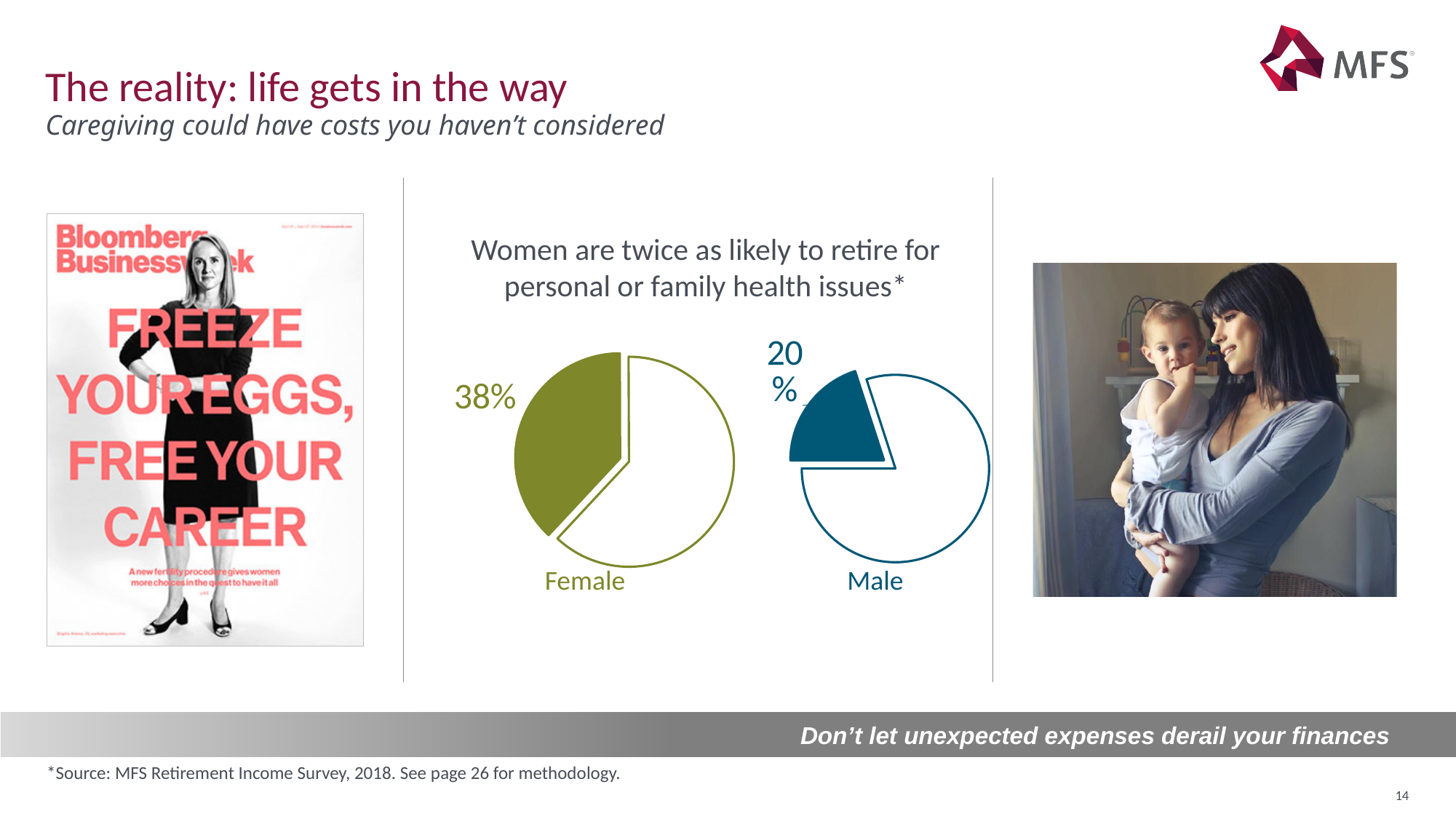
In the Female pie chart, what percentage is shown for the highlighted slice? 38% What kind of charts are used to show the Female and Male figures? Pie charts Comparing the Female and Male pie charts, which group has the larger highlighted share? Female How many pie charts are shown on the slide? 2 Comparing the Female and Male pie charts, which group has the smaller highlighted share? Male In the Male pie chart, what percentage is shown for the highlighted slice? 20% Is the highlighted value in the Male pie chart greater or less than 25%? less What is the heading above the Female and Male pie charts? Women are twice as likely to retire for personal or family health issues* What is the difference in percentage points between the Female pie chart value (38%) and the Male pie chart value (20%)? 18 percentage points In the Male pie chart, what share of the pie does the highlighted slice represent? 20% In the Female pie chart, what share of the pie does the highlighted slice represent? 38% What colour is the highlighted slice in the Female pie chart? Olive green